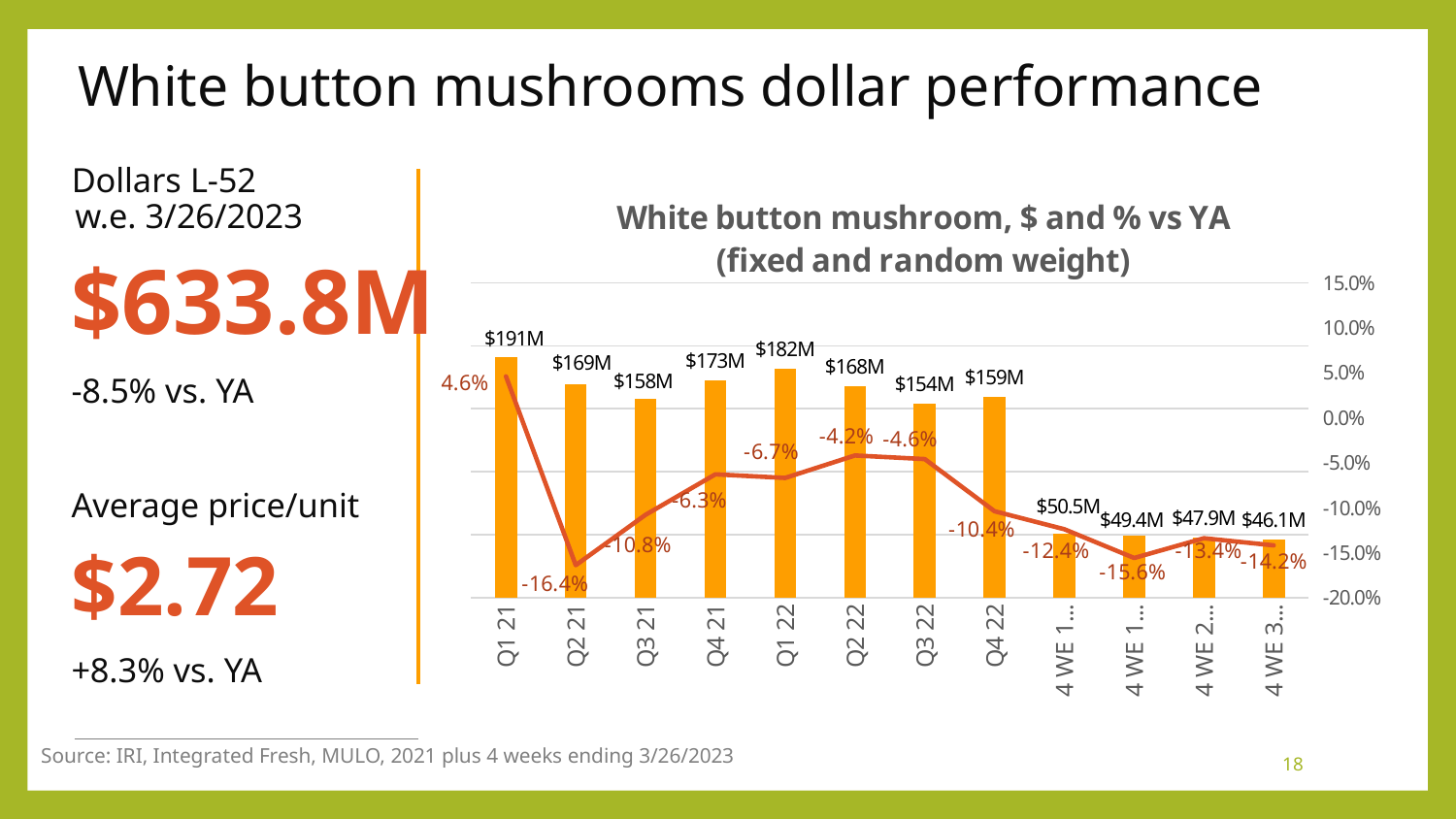
Which period has the lowest % vs YA value? Q2 21 What kind of chart is this? Combination bar and line chart What is the title of the chart? White button mushroom, $ and % vs YA (fixed and random weight) Is the % vs YA value for Q3 22 greater or less than -10.0%? greater Which quarter has the highest dollar value? Q1 21 What is the dollar value for Q1 21? $191M What is the dollar value for Q1 22? $182M What is the % vs YA value for Q2 22? -4.2% Which has a higher dollar value, Q4 21 or Q3 22? Q4 21 What is the % vs YA value for Q2 21? -16.4% How many periods are shown on the x axis? 12 What is the difference in dollars between Q1 21 and Q2 21? $22M